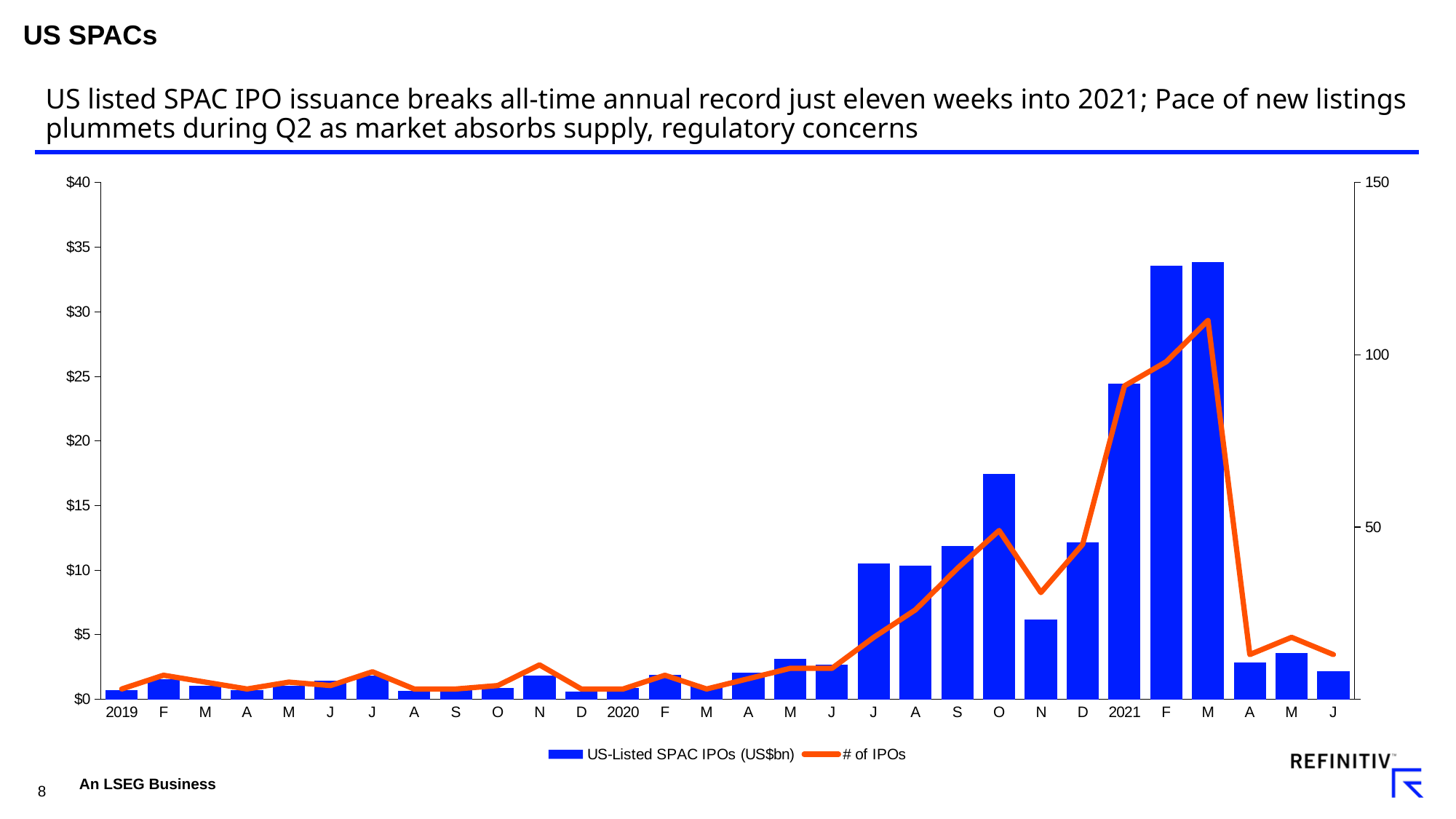
Which is larger, the US-Listed SPAC IPOs (US$bn) bar for O (October 2020) or for N (November 2020)? O (October 2020) How many monthly categories are shown along the x axis? 30 Is the US-Listed SPAC IPOs (US$bn) bar for N (November 2020) greater or less than $10? less Is the US-Listed SPAC IPOs (US$bn) bar for F (February 2021) greater or less than $30? greater Does the # of IPOs line rise or fall from N (November 2020) to M (March 2021)? rise What colour is the # of IPOs line? orange Is the # of IPOs value for A (April 2021) greater or less than 50? less What is the label of the series plotted as bars, as shown in the legend? US-Listed SPAC IPOs (US$bn) How many series does the legend list? 2 Which month has the highest value for the # of IPOs line? M (March 2021) What kind of chart is used to plot the US-Listed SPAC IPOs (US$bn) series? bar chart